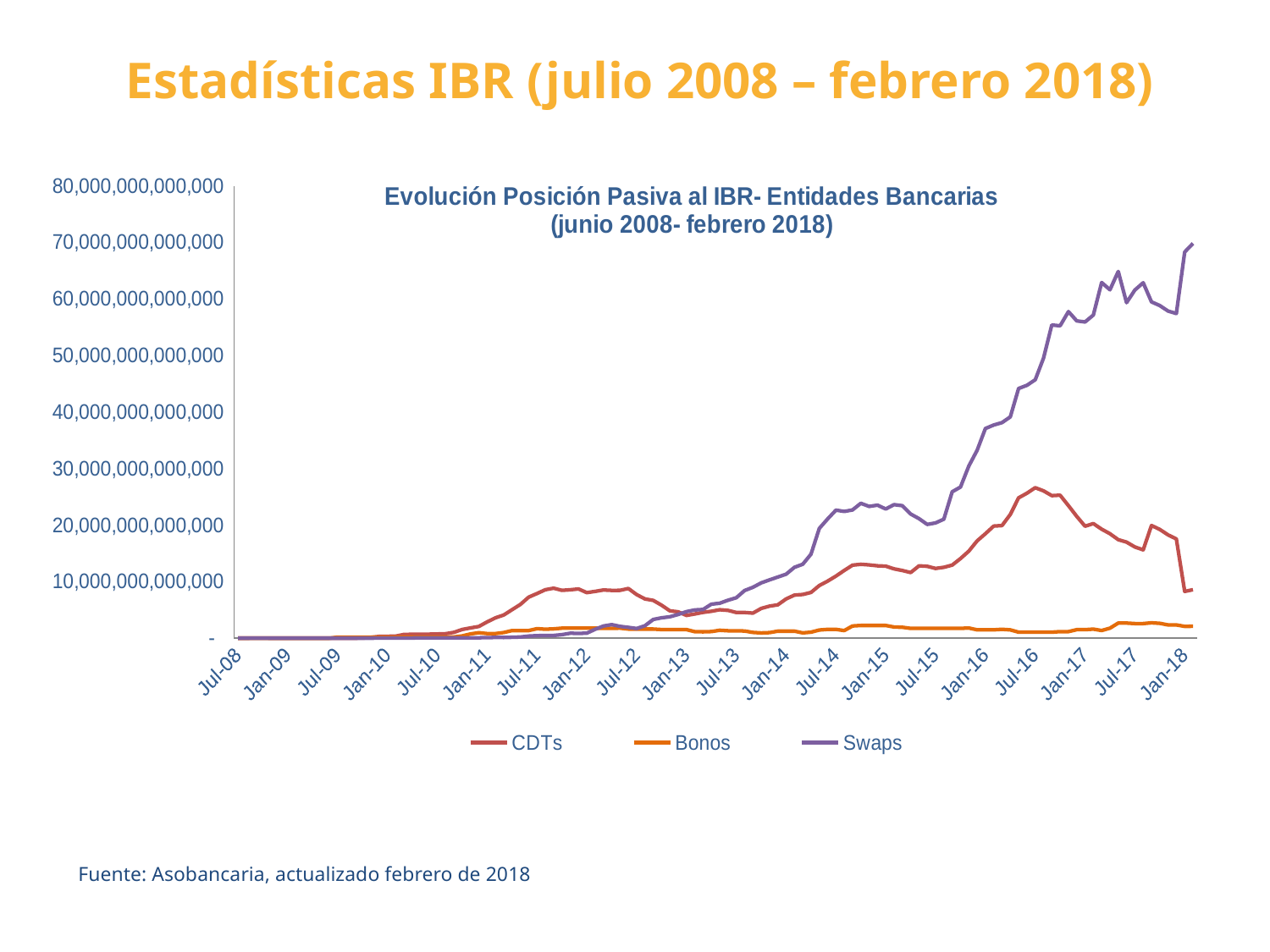
Is the value for CDTs at Jan-18 greater or less than 20,000,000,000,000? less Which series reaches the highest value on the chart? Swaps What are the three series named in the legend? CDTs, Bonos, Swaps What is the title of the chart? Evolución Posición Pasiva al IBR- Entidades Bancarias (junio 2008- febrero 2018) How many series does the legend list? 3 At Jan-18, which series is larger, Swaps or CDTs? Swaps Is the value for Swaps at Jul-16 greater or less than 40,000,000,000,000? greater How many date labels are shown on the x axis? 20 Does the Swaps series generally rise or fall from Jul-08 to Jan-18? Rise What kind of chart is shown on the slide? Line chart At Jul-11, which series is larger, CDTs or Swaps? CDTs